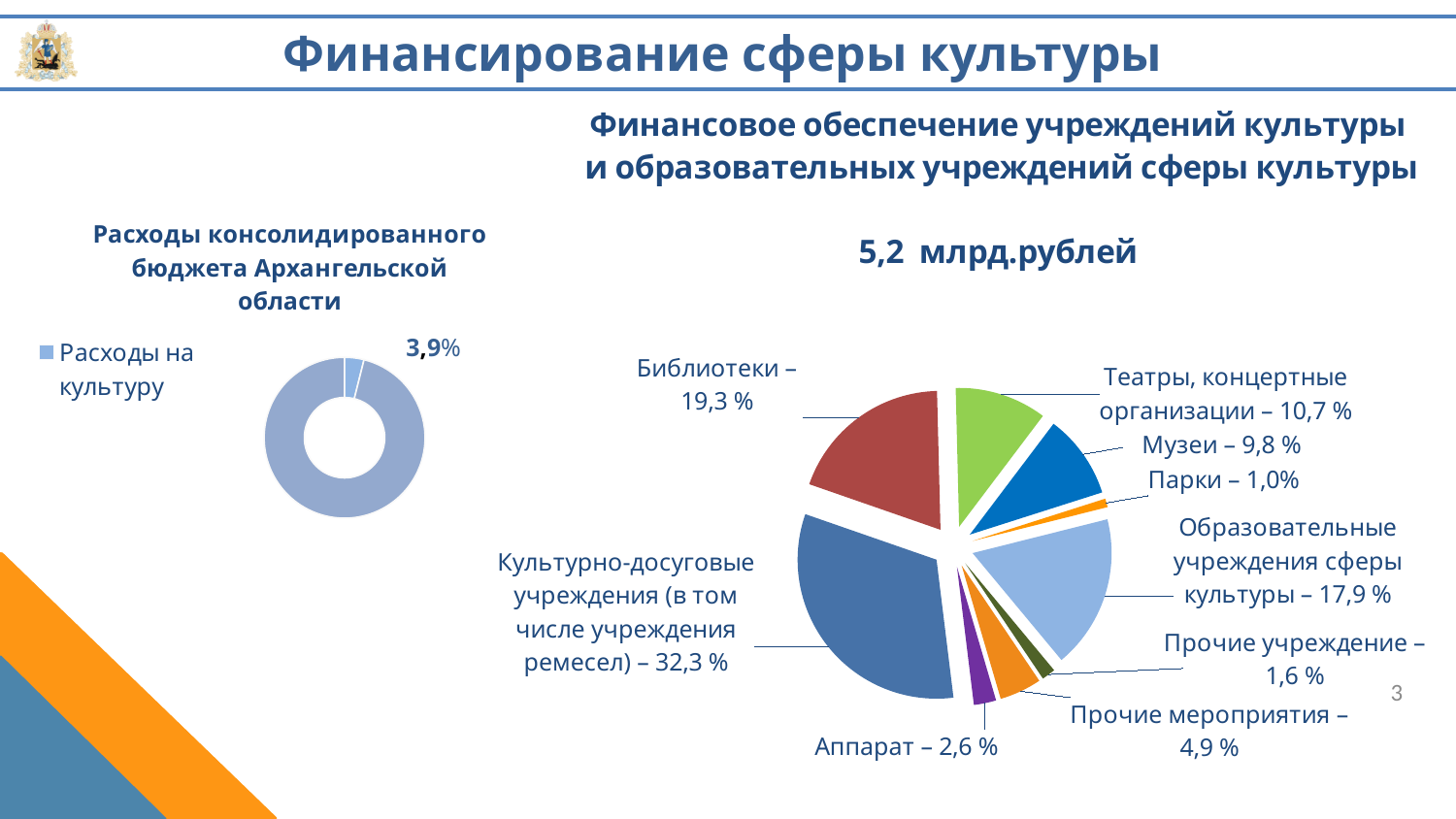
In the donut chart on the left, what value is shown for Расходы на культуру? 3,9% In the pie chart on the right, how many percentage points larger is the share of Культурно-досуговые учреждения than the share of Библиотеки? 13,0 What kind of chart is the chart on the right of the slide? Pie chart In the pie chart on the right, which has the larger share: Музеи or Прочие мероприятия? Музеи How many slices does the pie chart on the right have? 9 In the pie chart on the right, what share goes to Библиотеки? 19,3 % In the pie chart on the right, which category has the smallest share? Парки In the pie chart on the right, what share goes to Аппарат? 2,6 % What total amount is stated above the pie chart on the right? 5,2 млрд.рублей In the pie chart on the right, what share goes to Театры, концертные организации? 10,7 % In the pie chart on the right, which category has the largest share? Культурно-досуговые учреждения (в том числе учреждения ремесел) In the pie chart on the right, what share goes to Образовательные учреждения сферы культуры? 17,9 %